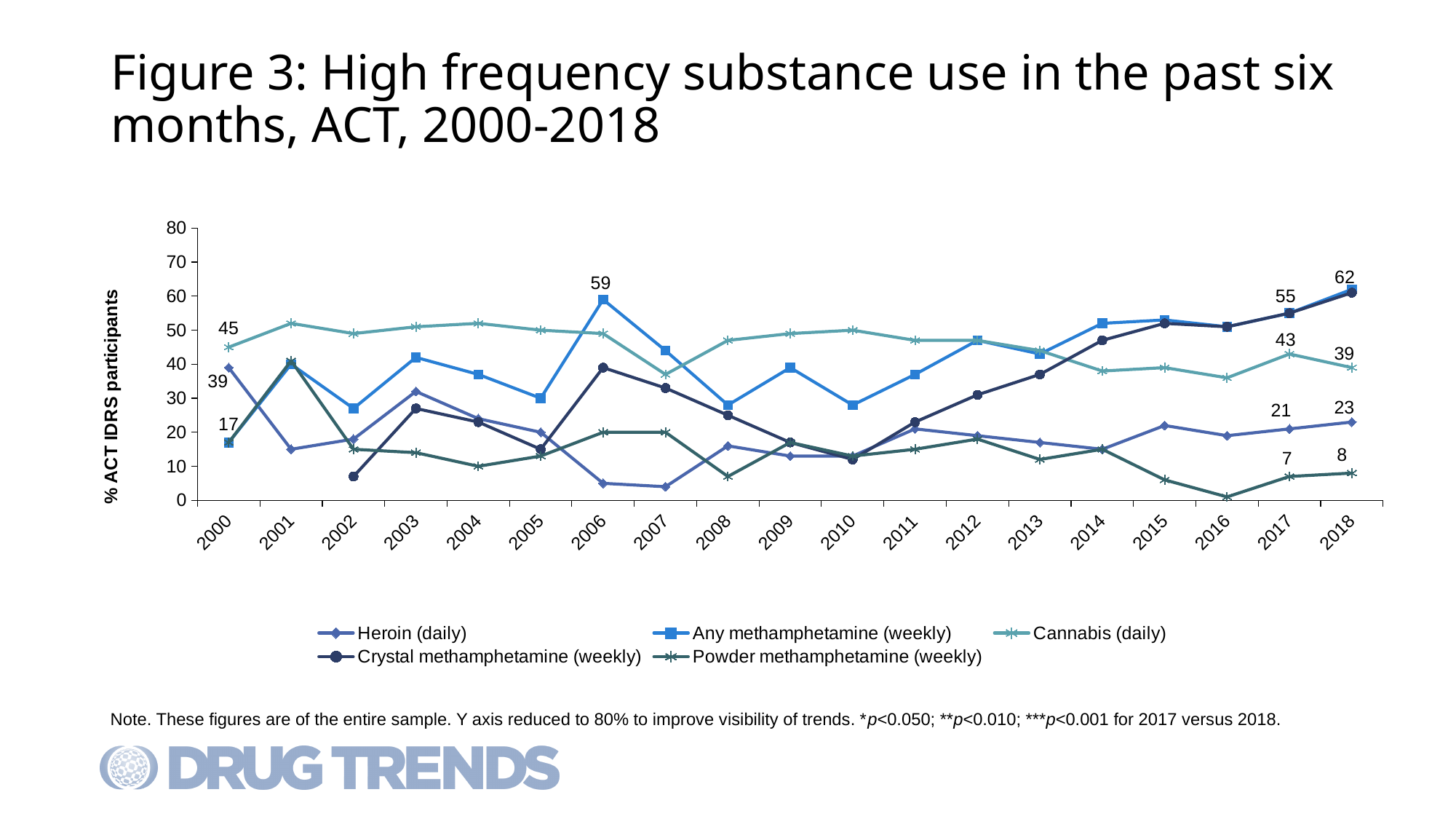
What is the label on the y axis? % ACT IDRS participants How many years are plotted along the x axis? 19 What is the value for Heroin (daily) in 2000? 39 Which series has the lowest value in 2018? Powder methamphetamine (weekly) What is the value for Any methamphetamine (weekly) in 2006? 59 Which is larger in 2018, the value for Cannabis (daily) or the value for Heroin (daily)? Cannabis (daily) How many series does the legend list? 5 What kind of chart is shown on the slide? line chart What is the value for Cannabis (daily) in 2000? 45 What is the difference between the Cannabis (daily) values in 2000 and 2018? 6 Is the value for Cannabis (daily) in 2010 greater or less than 40? greater What is the value for Powder methamphetamine (weekly) in 2017? 7